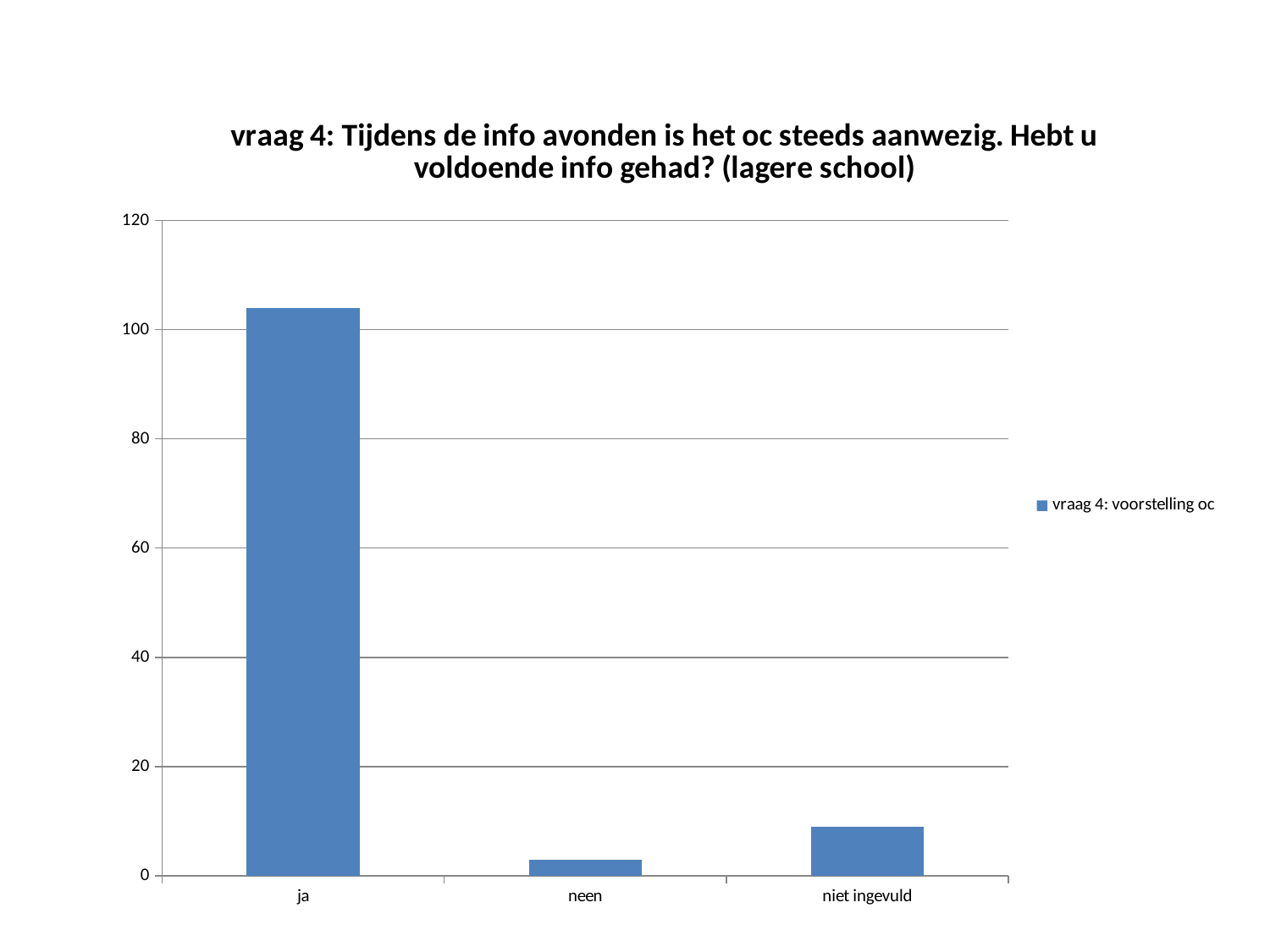
How many series does the legend list? 1 Is the value for ja greater or less than 100? greater Which category has the lowest value? neen Is the value for neen greater or less than 20? less Which category has the highest value? ja How many categories are shown on the x axis? 3 What is the name of the series listed in the legend? vraag 4: voorstelling oc Which is larger, the value for niet ingevuld or the value for neen? niet ingevuld Is the value for niet ingevuld greater or less than 20? less Which is larger, the value for ja or the value for niet ingevuld? ja What is the highest value shown on the y axis? 120 What kind of chart is shown on the slide? bar chart